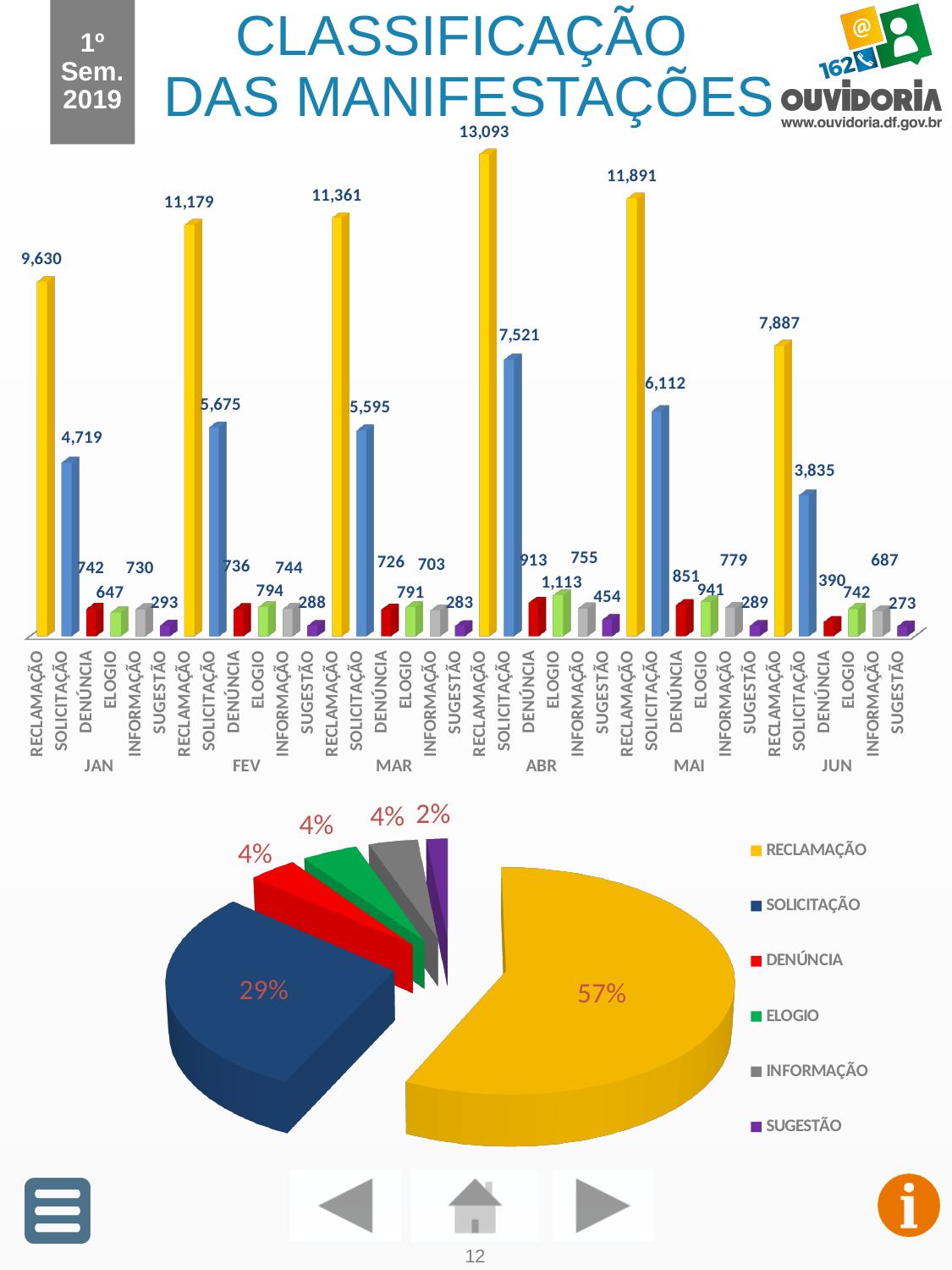
In the top bar chart, which month has the lowest SOLICITAÇÃO value? JUN In the top bar chart, how many months are shown on the x axis? 6 In the bottom pie chart, what share does SOLICITAÇÃO have? 29% How many entries does the legend of the bottom pie chart list? 6 What kind of chart is the top chart on the slide? Bar chart In the top bar chart, what is the difference between RECLAMAÇÃO in ABR and RECLAMAÇÃO in JUN? 5,206 In the top bar chart, what is the value for RECLAMAÇÃO in ABR? 13,093 In the bottom pie chart, what share does RECLAMAÇÃO have? 57% In the top bar chart, what is the value for ELOGIO in ABR? 1,113 In the top bar chart, which month has the highest RECLAMAÇÃO value? ABR In the top bar chart, which is larger: DENÚNCIA in MAI or DENÚNCIA in JUN? DENÚNCIA in MAI In the top bar chart, what is the value for SOLICITAÇÃO in JUN? 3,835